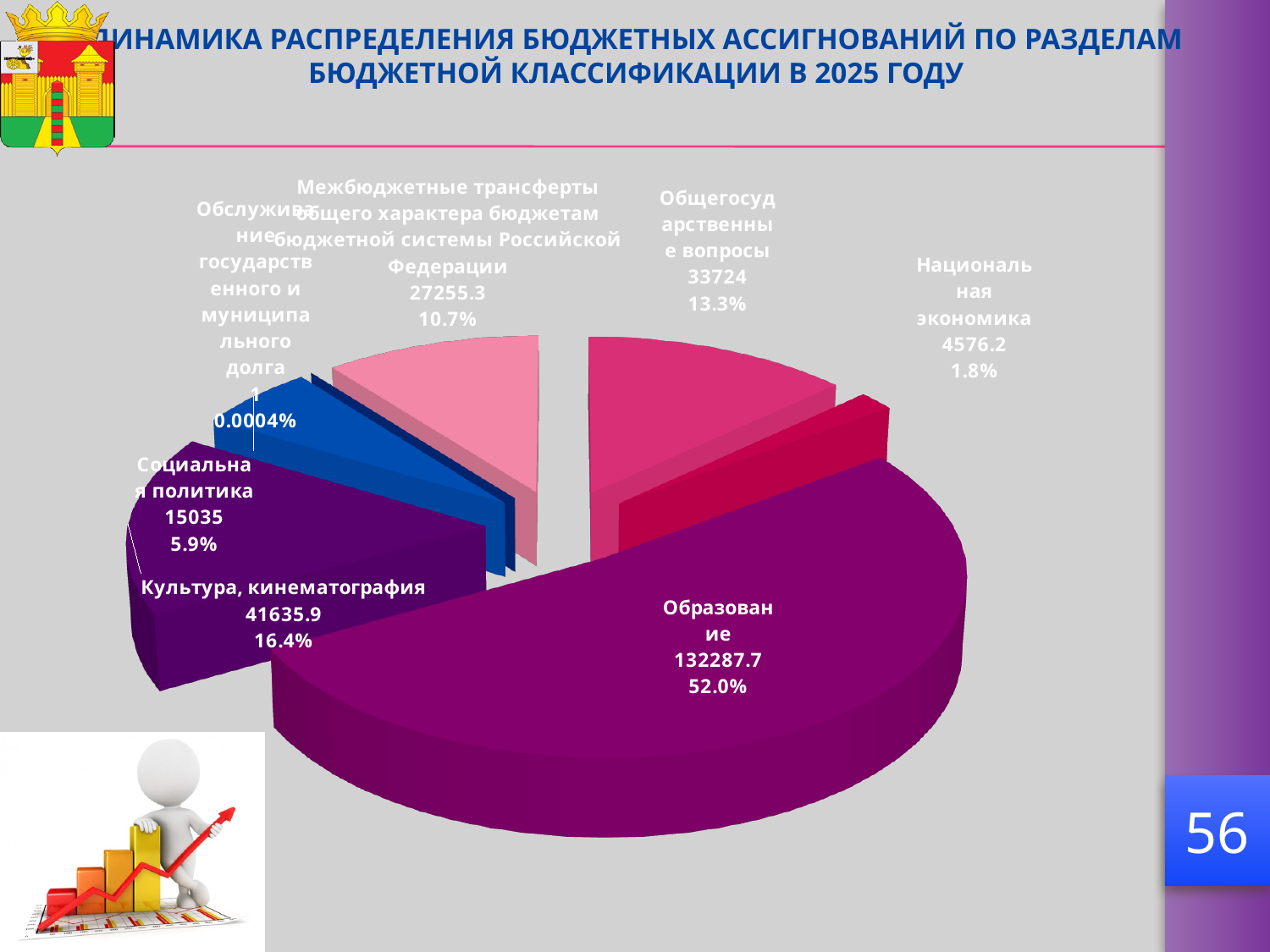
What is the value for Культура, кинематография? 41635.9 What is the value for Образование? 132287.7 What share of the pie does Социальная политика account for? 5.9% What is the value for Национальная экономика? 4576.2 How many categories (slices) does the pie chart show? 7 What share of the pie does Образование account for? 52.0% What is the difference between the values for Образование and Культура, кинематография? 90651.8 What kind of chart is shown on the slide? pie chart Which category has the smallest slice of the pie? Обслуживание государственного и муниципального долга Which is larger, the value for Общегосударственные вопросы or the value for Межбюджетные трансферты общего характера бюджетам бюджетной системы Российской Федерации? Общегосударственные вопросы Which category has the largest slice of the pie? Образование What is the value for Общегосударственные вопросы? 33724